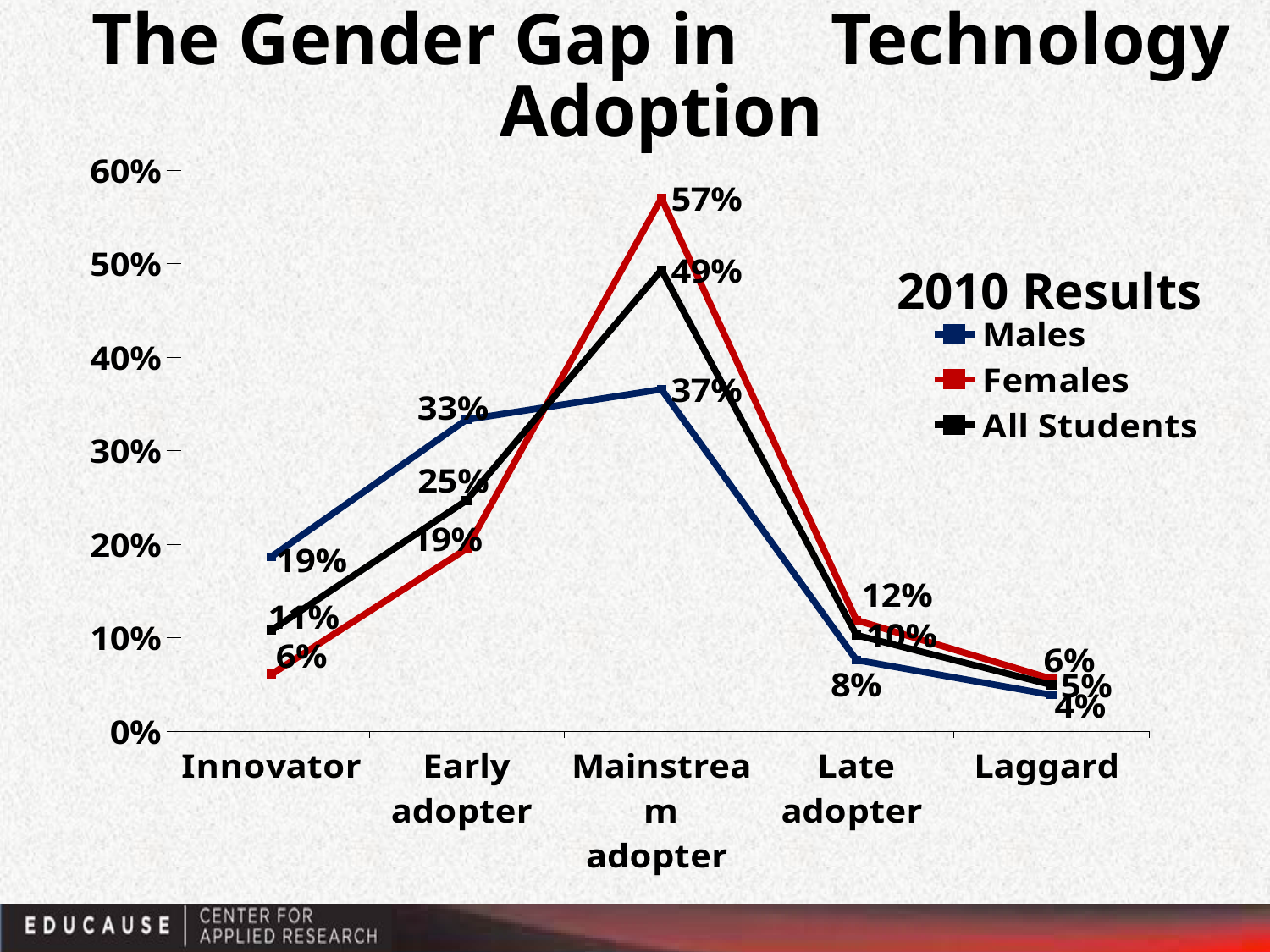
How many categories are shown on the x axis? 5 What is the value for All Students in the Innovator category? 11% What is the value for Females in the Laggard category? 6% What is the value for Females in the Mainstream adopter category? 57% What is the value for Males in the Early adopter category? 33% What is the difference between the Females and Males values in the Mainstream adopter category? 20% Which is larger in the Innovator category, the Males value or the Females value? Males How many series does the legend list? 3 In which category is the Males series highest? Mainstream adopter What is the title of the legend box on the chart? 2010 Results What type of chart is shown on the slide? line chart In which category is the Females series lowest? Innovator